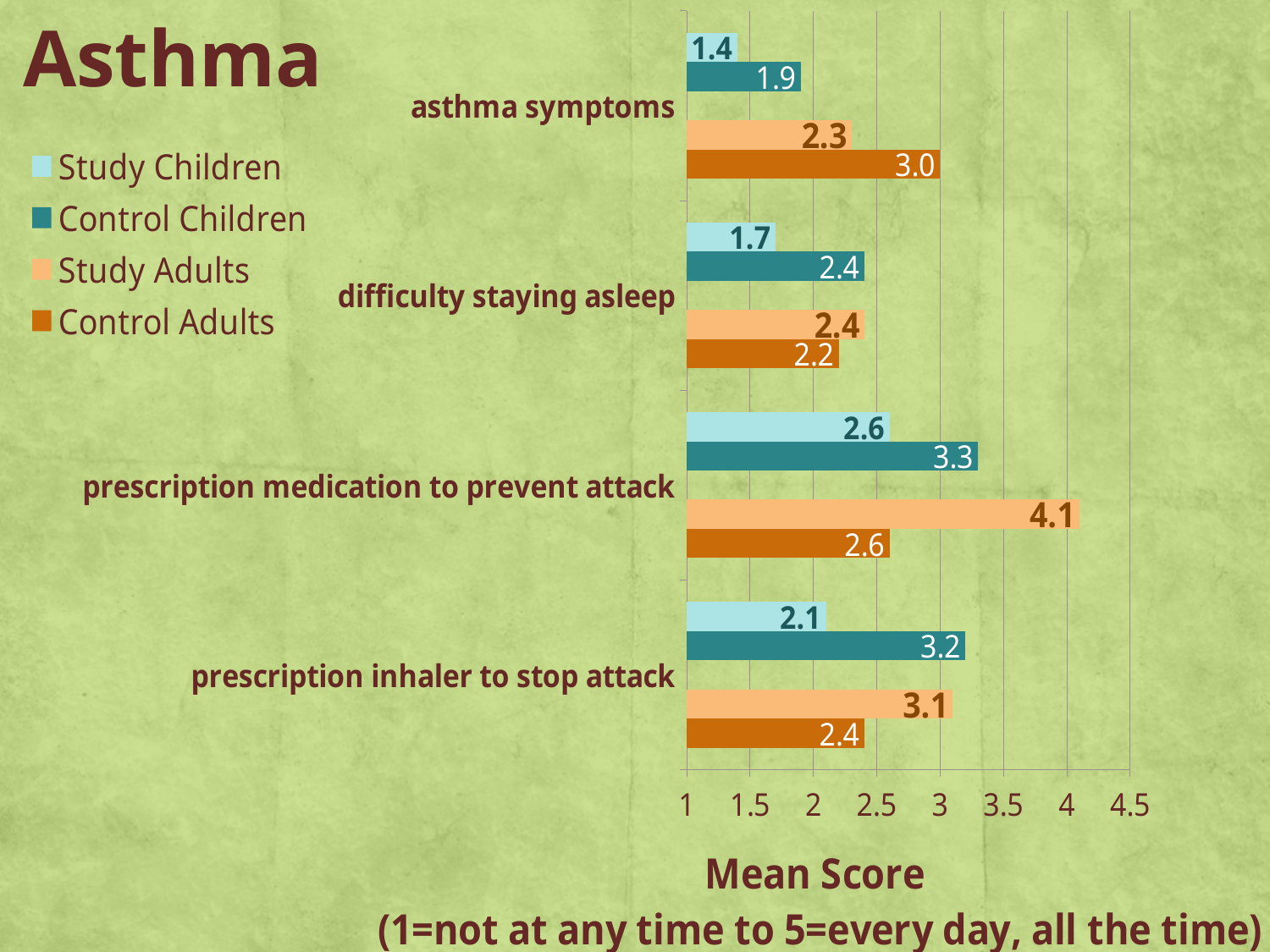
What is the mean score for Study Adults for prescription medication to prevent attack? 4.1 What is the difference between the Control Adults and Study Children mean scores for asthma symptoms? 1.6 How many series does the legend list? 4 What is the mean score for Study Children for difficulty staying asleep? 1.7 How many categories are shown on the chart? 4 What is the mean score for Control Children for prescription inhaler to stop attack? 3.2 What is the mean score for Control Adults for asthma symptoms? 3.0 Which series has the lowest mean score for asthma symptoms? Study Children Which series has the highest mean score for prescription medication to prevent attack? Study Adults What is the label of the horizontal axis? Mean Score Which is larger for prescription inhaler to stop attack: the Control Children score or the Study Adults score? Control Children What kind of chart is shown on the slide? Bar chart